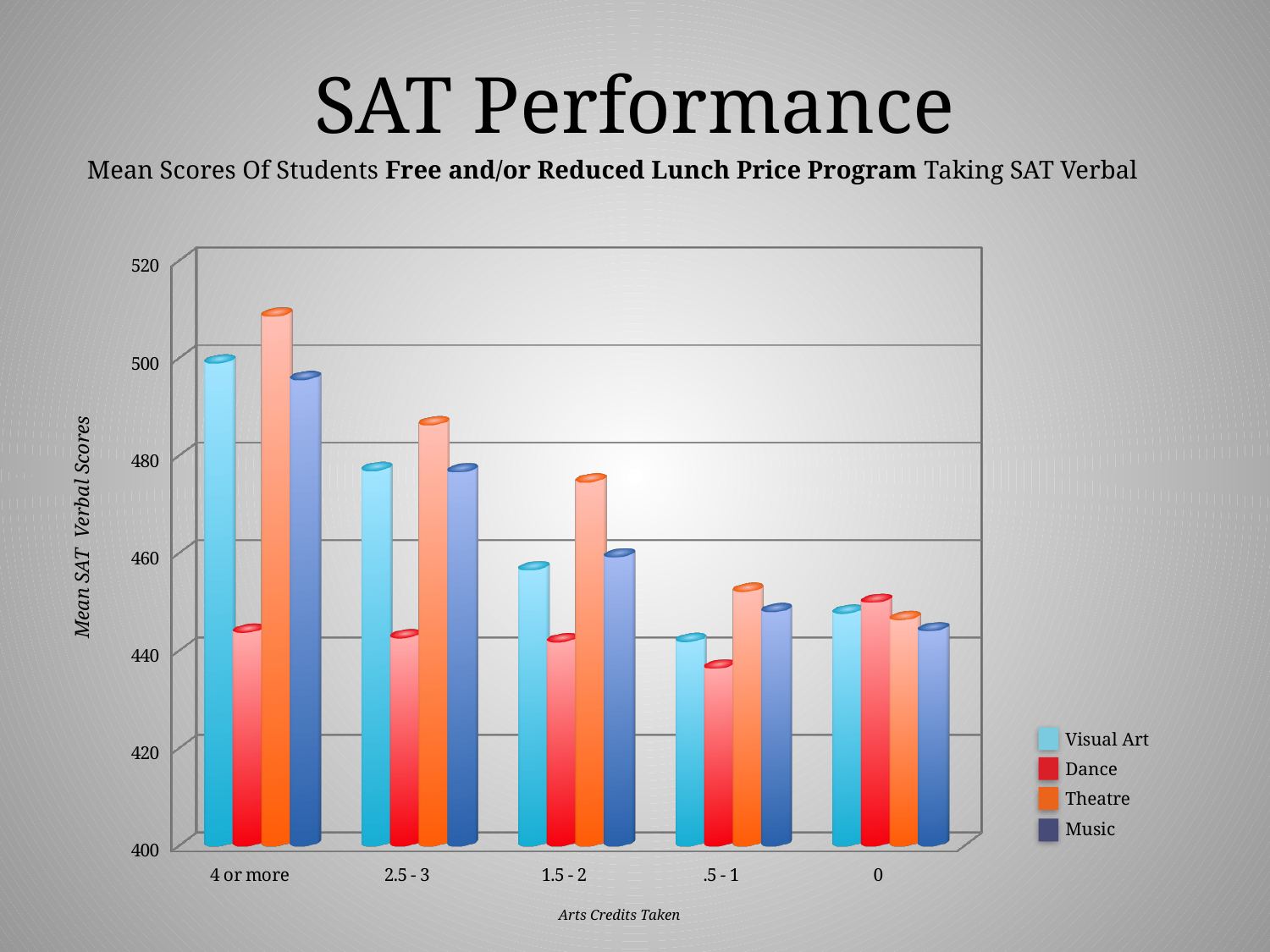
Is the Theatre value for '2.5 - 3' greater or less than 480? greater Is the Dance value for '4 or more' greater or less than 460? less How many arts-credit categories are shown on the x axis? 5 How many series does the legend list? 4 Which is larger in the '1.5 - 2' category, the Theatre value or the Dance value? Theatre Do the Theatre values rise or fall moving from '4 or more' to '0' along the x axis? fall Which series has the highest bar in the '4 or more' category? Theatre Is the Theatre value for '4 or more' greater or less than 500? greater What kind of chart is shown on the slide? bar chart What is the title of the vertical axis? Mean SAT Verbal Scores Which series has the lowest bar in the '.5 - 1' category? Dance